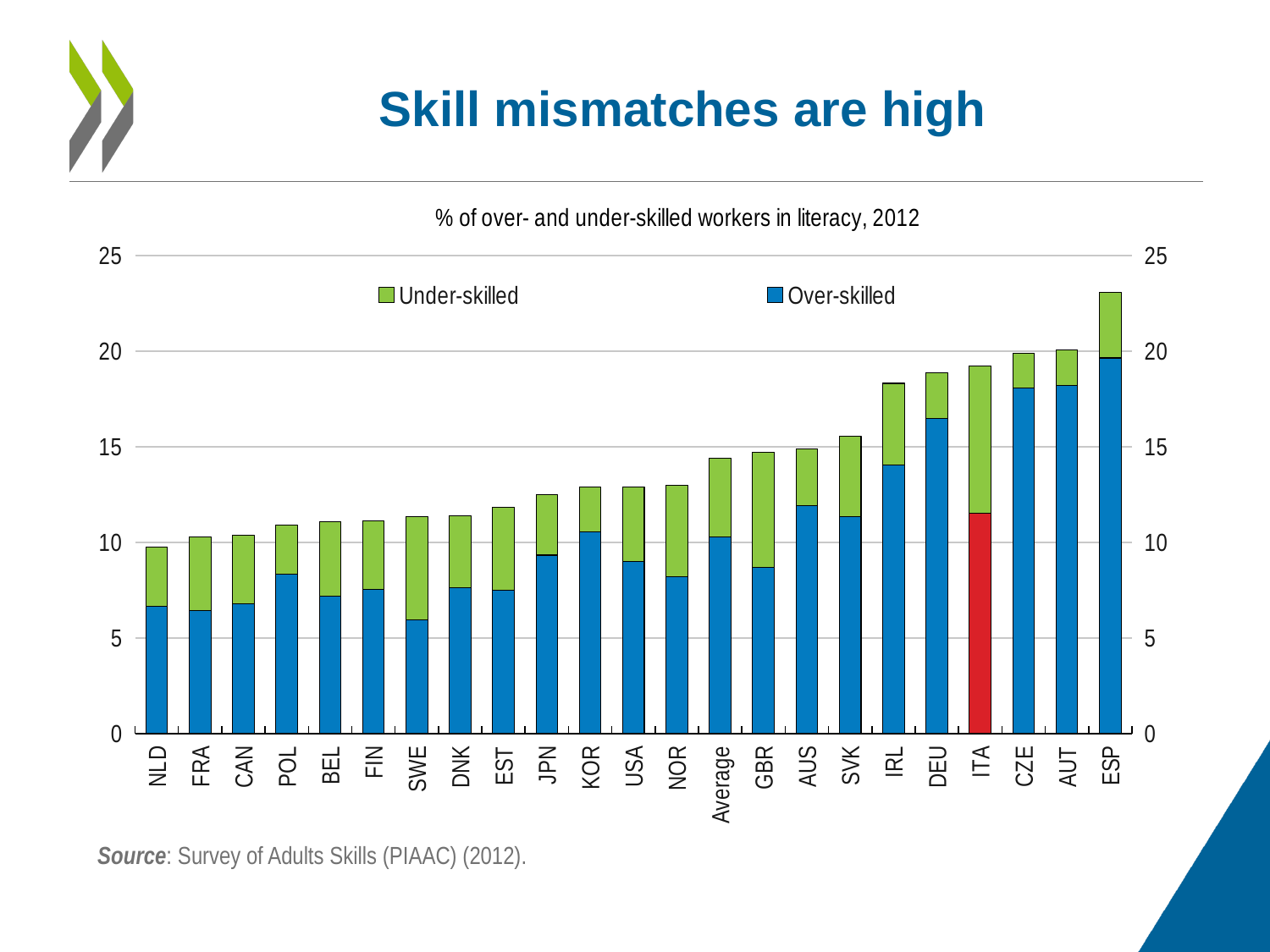
Do the total bar heights generally rise or fall from left to right along the x axis? rise Is the total value for IRL greater or less than 20? less Is the Over-skilled value for ESP greater or less than 15? greater How many series does the legend list? 2 Which category has the lowest total bar? NLD Is the Over-skilled value for ITA greater or less than 10? greater What kind of chart is shown on the slide? Stacked bar chart How many categories are shown on the x axis? 23 Which category has the highest total bar? ESP Which category's Over-skilled bar is highlighted in red? ITA Which has the larger Under-skilled value, ITA or ESP? ITA